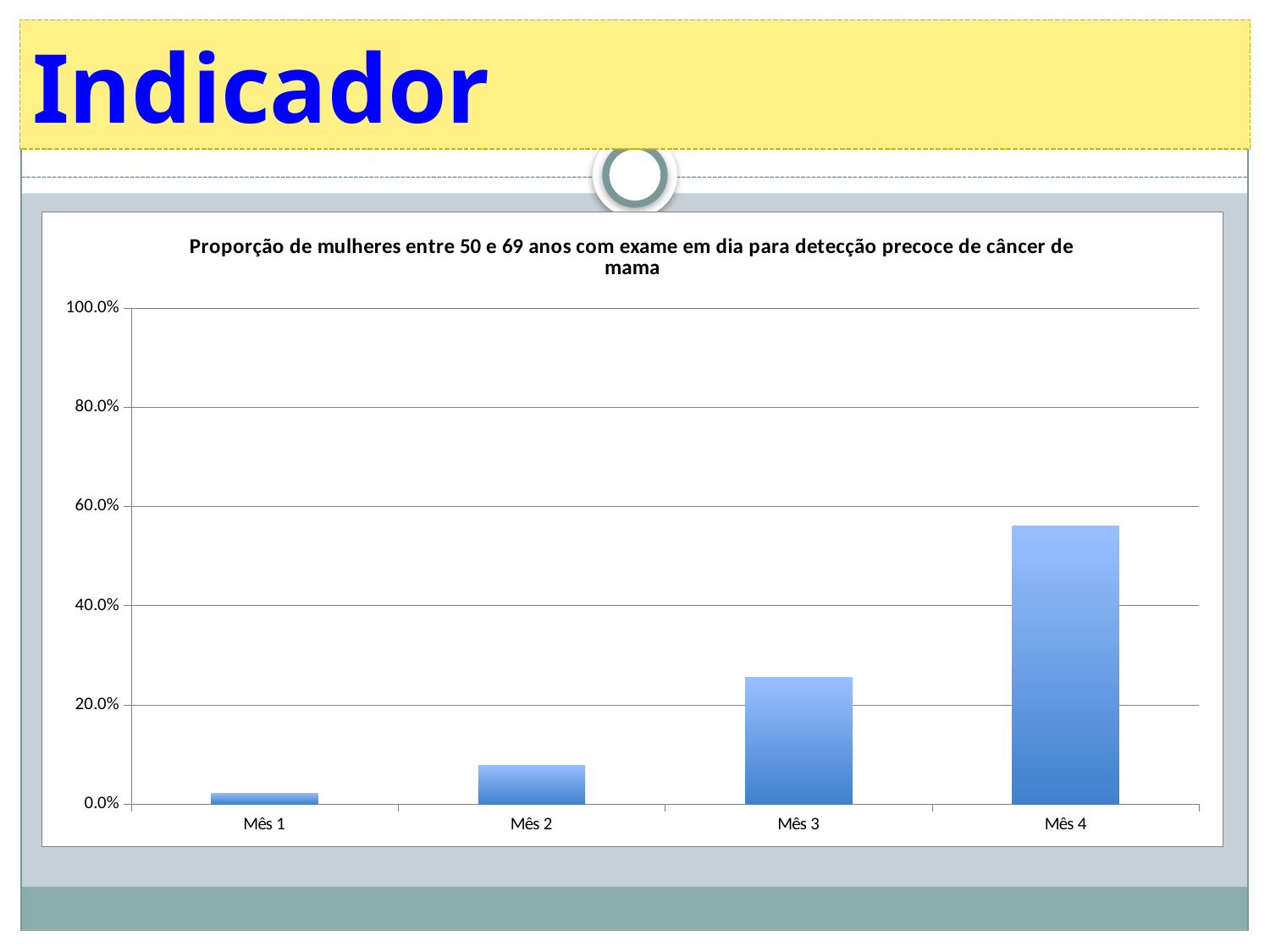
What kind of chart is shown on the slide? bar chart Is the value for Mês 1 greater or less than 20.0%? less How many categories (months) are plotted on the chart? 4 What is the title of the chart? Proporção de mulheres entre 50 e 69 anos com exame em dia para detecção precoce de câncer de mama Is the value for Mês 3 greater or less than 20.0%? greater Which is larger, the value for Mês 2 or the value for Mês 3? Mês 3 Is the value for Mês 4 greater or less than 40.0%? greater Which month has the highest value? Mês 4 Do the values rise or fall from Mês 1 to Mês 4? rise Which month has the lowest value? Mês 1